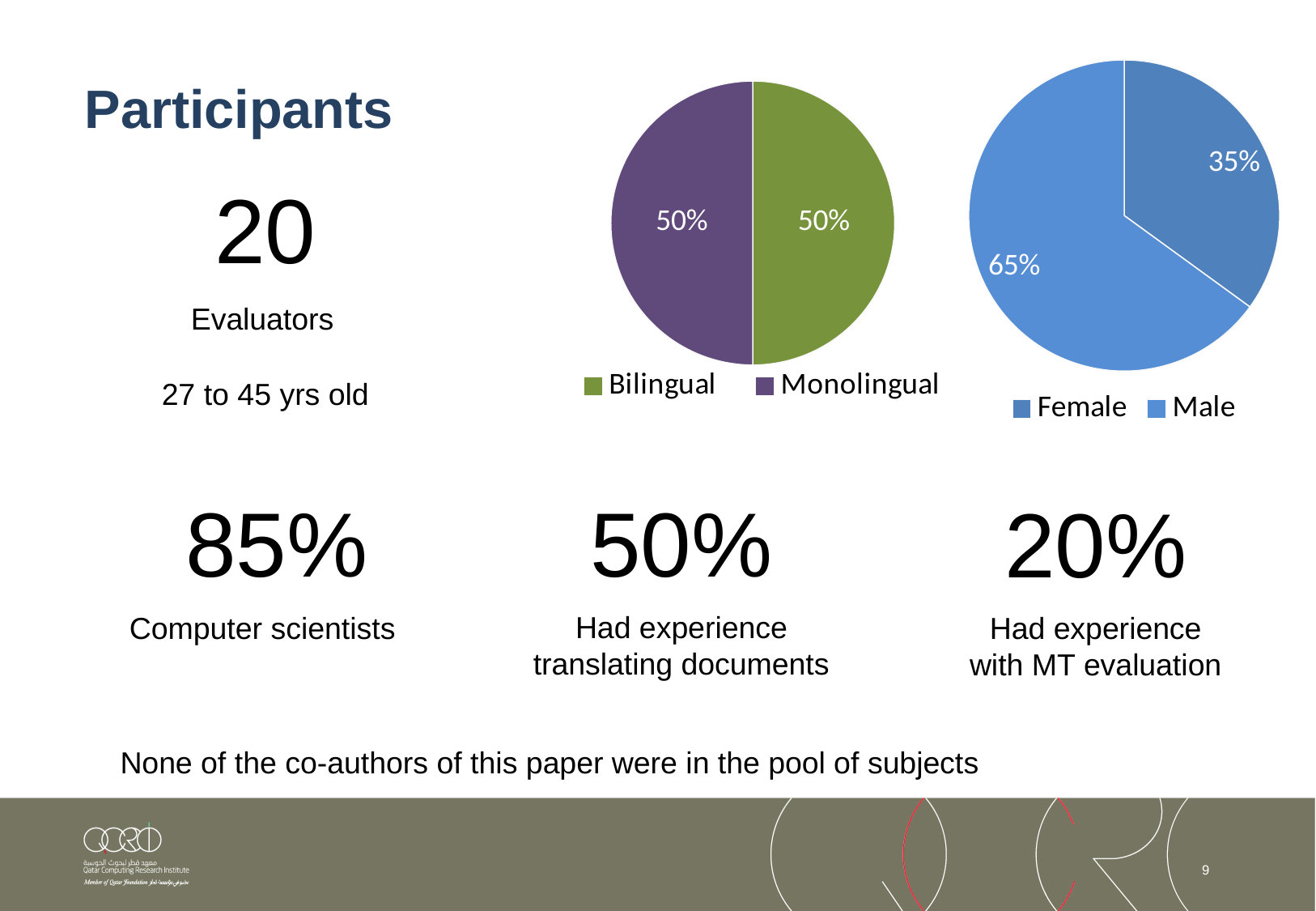
How many entries does the legend of the right pie chart list? 2 In the right pie chart, what share is labelled for Female? 35% In the left pie chart, what share is labelled for Monolingual? 50% What kind of chart is the left chart on the slide? Pie chart In the left pie chart, what share is labelled for Bilingual? 50% In the right pie chart, what is the difference between the Male and Female shares? 30% In the right pie chart, which category has the largest slice? Male In the right pie chart, which category has the smallest slice? Female What are the two legend entries of the left pie chart? Bilingual and Monolingual In the right pie chart, which is larger, the Female slice or the Male slice? Male How many slices does the left pie chart have? 2 In the right pie chart, what share is labelled for Male? 65%